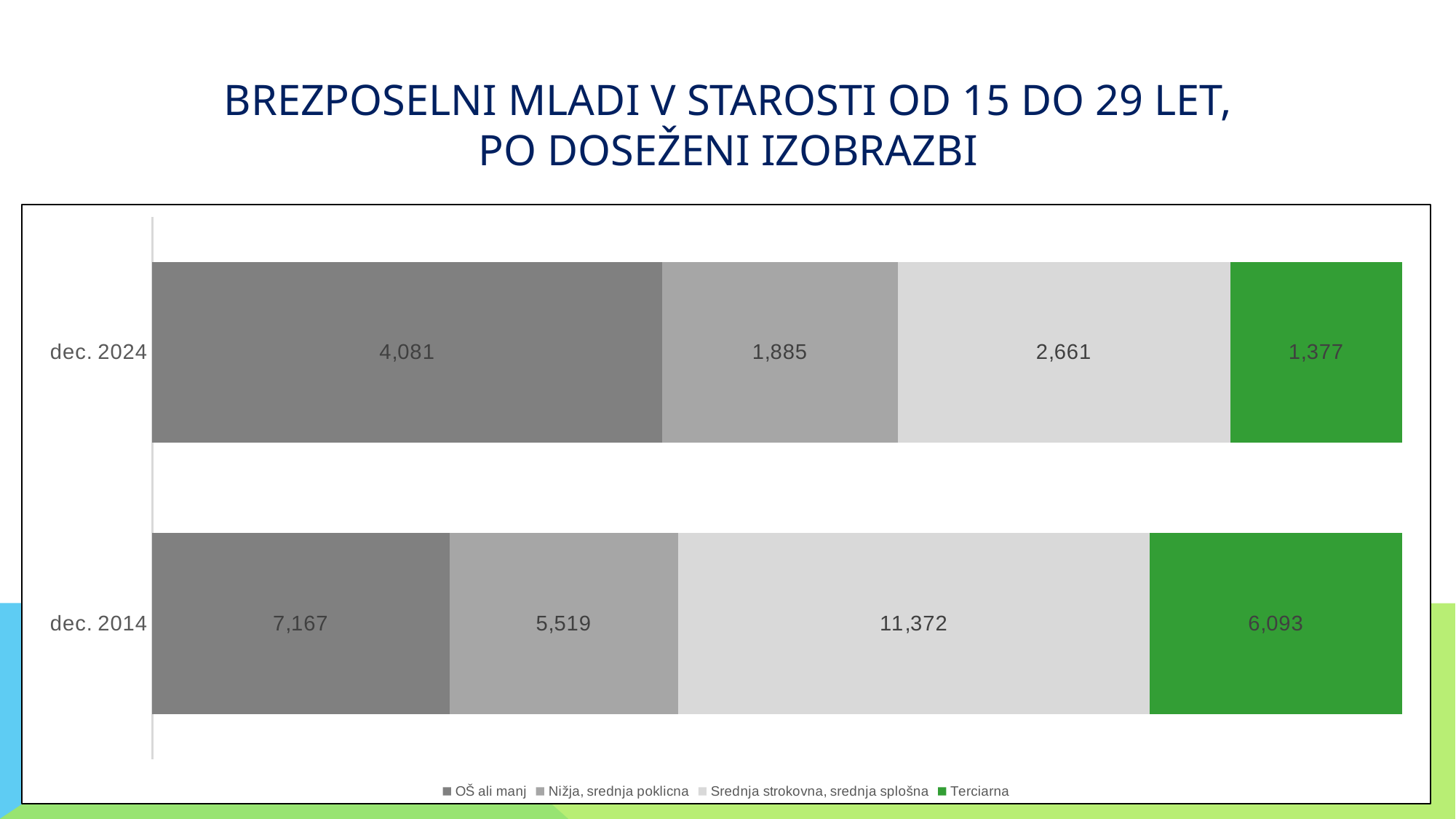
What is the value for 'Srednja strokovna, srednja splošna' in dec. 2014? 11,372 Which education group has the highest value in dec. 2014? Srednja strokovna, srednja splošna How many categories (time points) are shown on the chart? 2 What kind of chart is shown on the slide? stacked bar chart What is the total of the dec. 2024 bar? 10,004 What is the value for 'Nižja, srednja poklicna' in dec. 2024? 1,885 How many series does the legend list? 4 Which is larger: 'Terciarna' in dec. 2014 or 'Terciarna' in dec. 2024? dec. 2014 Which education group has the lowest value in dec. 2024? Terciarna What is the value for 'Terciarna' in dec. 2014? 6,093 What is the difference between the 'OŠ ali manj' values for dec. 2014 and dec. 2024? 3,086 What is the value for 'OŠ ali manj' in dec. 2024? 4,081